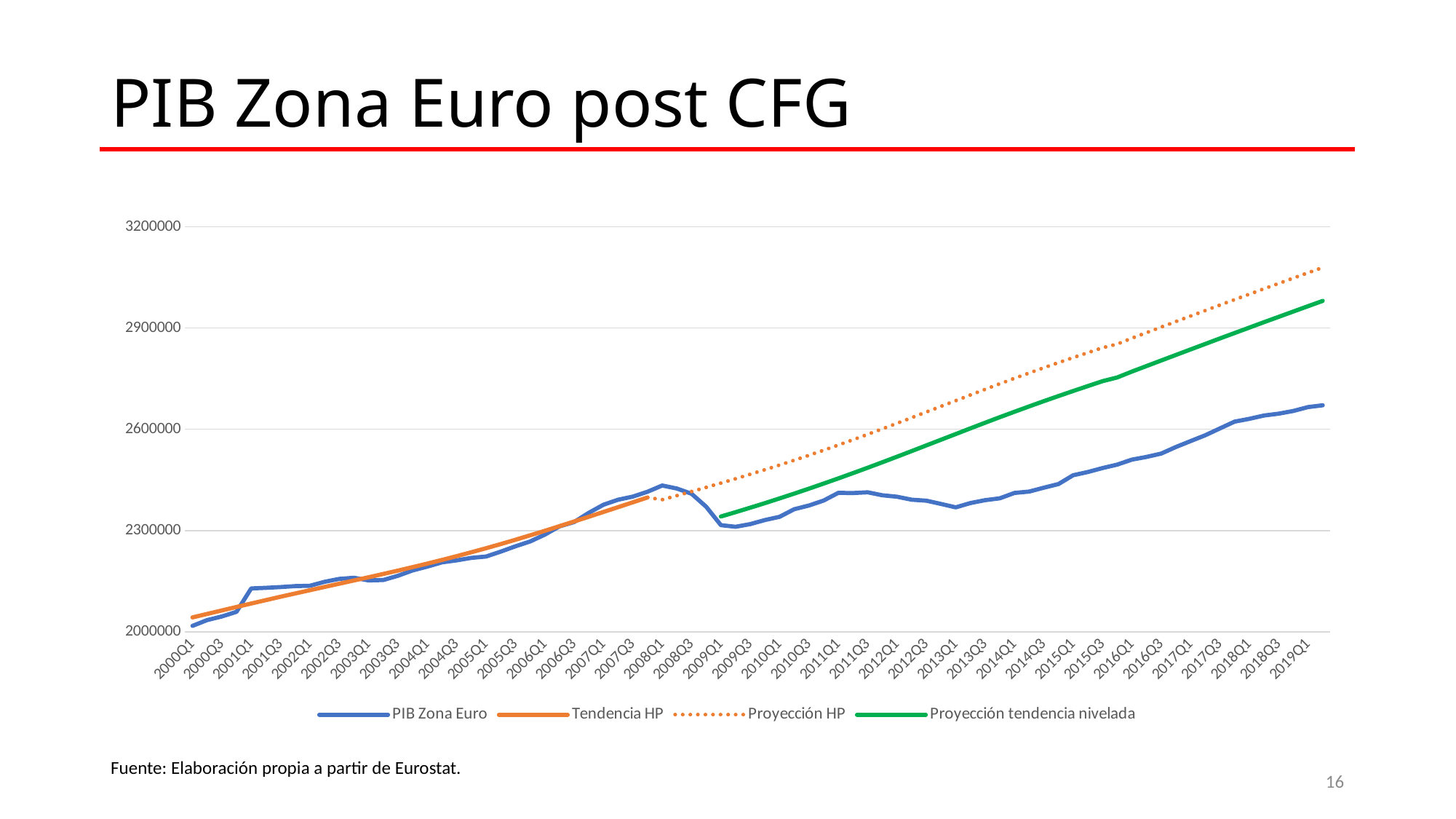
At 2019Q1, which is higher: PIB Zona Euro or Proyección tendencia nivelada? Proyección tendencia nivelada Is the value of PIB Zona Euro at 2013Q1 greater or less than 2600000? less What is the title of the chart on the slide? PIB Zona Euro post CFG Which series has the highest value at 2019Q1? Proyección HP What kind of chart is shown on the slide? Line chart Is the value of Proyección tendencia nivelada at 2019Q1 greater or less than 2900000? greater Is the value of PIB Zona Euro at 2019Q1 greater or less than 2600000? greater At 2019Q1, which is higher: Proyección HP or Proyección tendencia nivelada? Proyección HP How many series does the legend list? 4 Which series in the legend is drawn as a dotted line? Proyección HP Does the PIB Zona Euro series rise or fall between 2008Q1 and 2009Q3? Fall